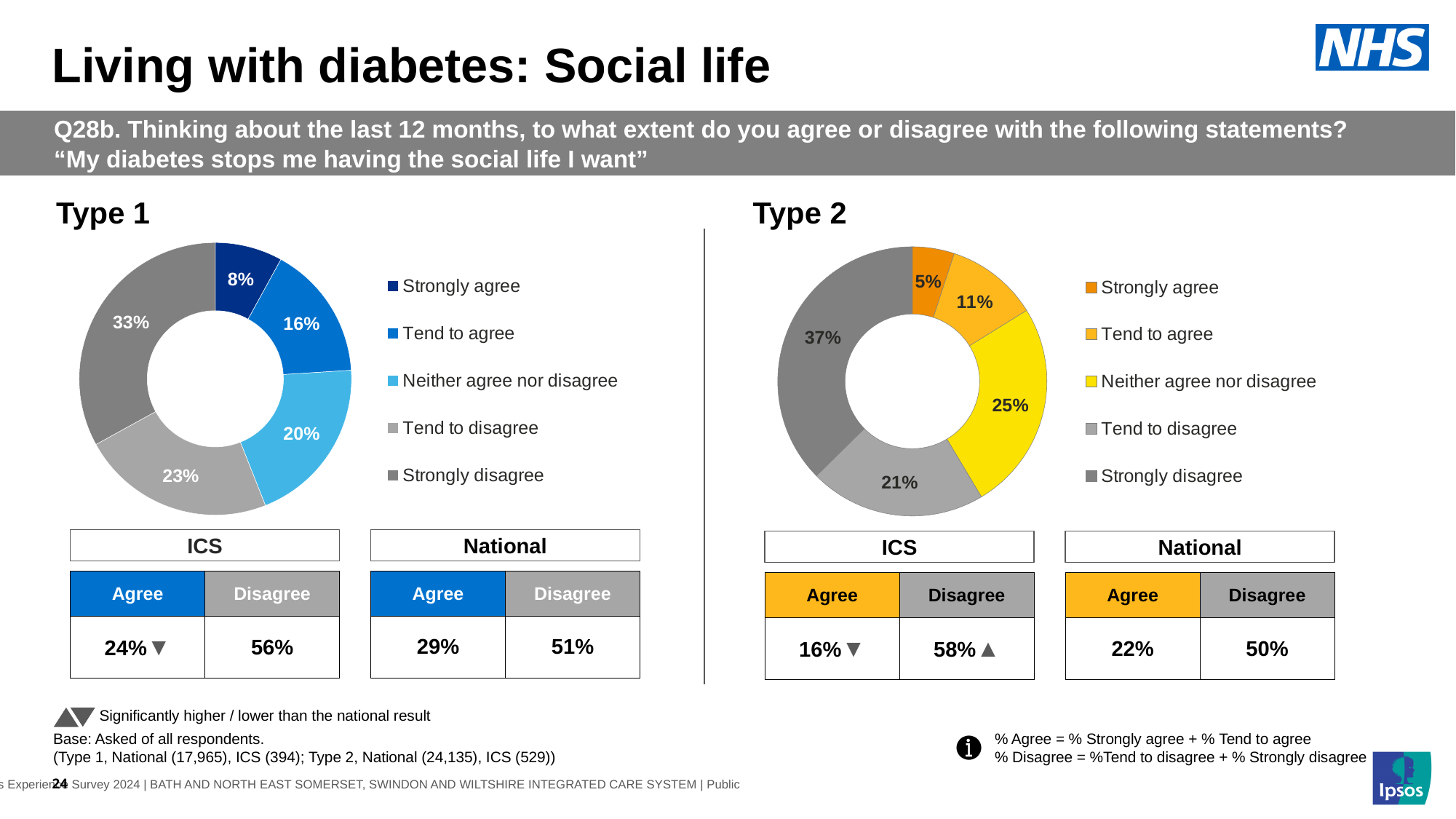
How many response categories does the legend of the Type 2 chart list? 5 In the Type 2 chart, is the share for 'Tend to disagree' larger or smaller than the share for 'Neither agree nor disagree'? smaller In the Type 2 chart, what percentage of respondents said 'Neither agree nor disagree'? 25% In the Type 2 chart, which response category has the smallest share? Strongly agree What type of chart is used to show the Type 1 results? Doughnut chart In the Type 1 chart, which response category has the smallest share? Strongly agree In the Type 2 chart, what is the combined share of 'Strongly agree' and 'Tend to agree'? 16% In the Type 2 chart, which response category has the largest share? Strongly disagree In the Type 1 chart, what colour represents 'Neither agree nor disagree'? Light blue In the Type 1 chart, what is the difference between the 'Strongly disagree' and 'Tend to disagree' percentages? 10% In the Type 1 chart, what percentage of respondents said 'Tend to agree'? 16% In the Type 1 chart, what percentage of respondents said 'Strongly disagree'? 33%